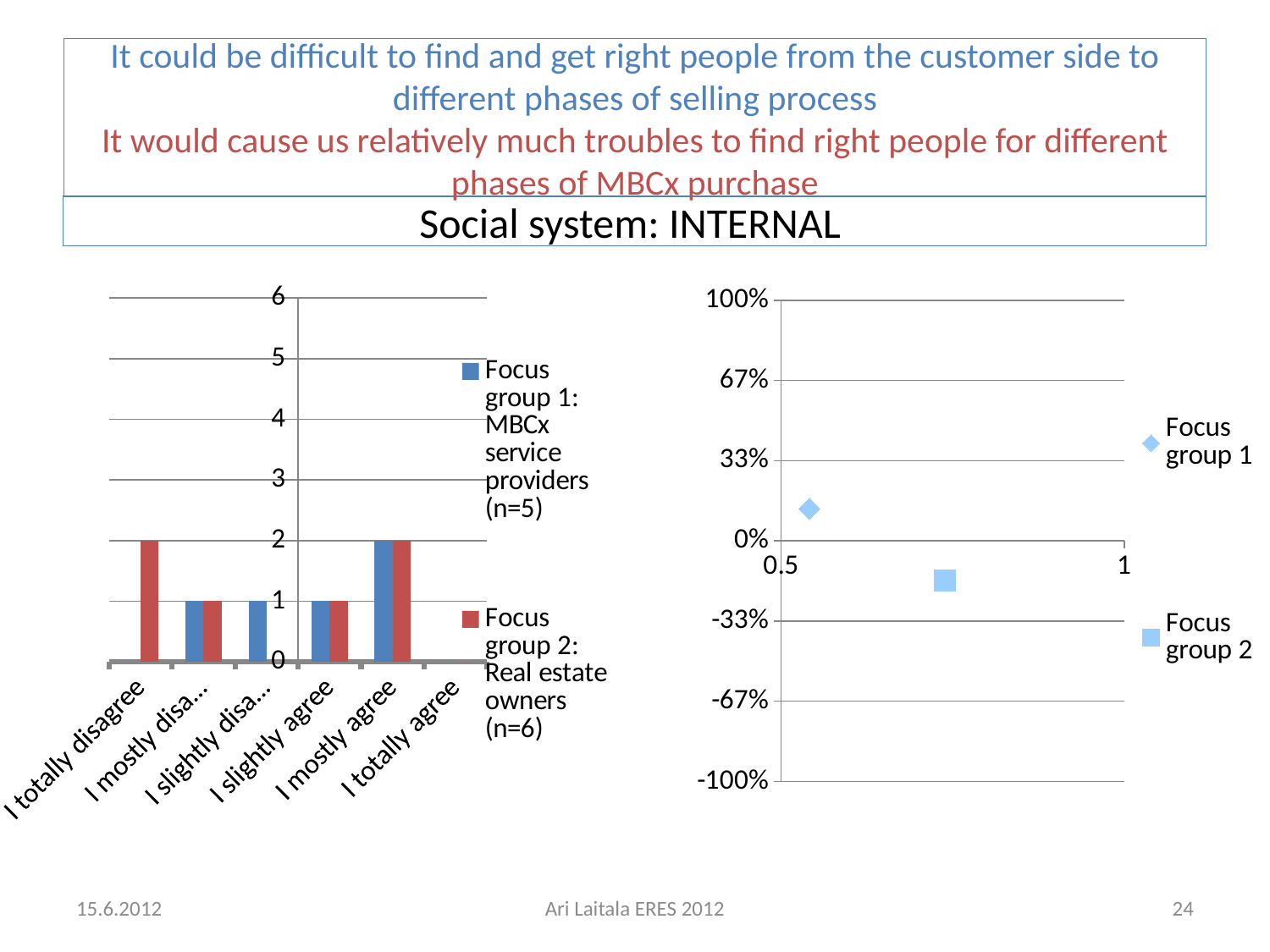
What kind of chart is the chart on the left of the slide? bar chart In the left bar chart, what is the value for Focus group 1: MBCx service providers (n=5) for 'I mostly agree'? 2 In the right scatter chart, is the value for Focus group 2 greater or less than 0%? less In the left bar chart, how many series does the legend list? 2 In the left bar chart, what is the value for Focus group 1: MBCx service providers (n=5) for 'I slightly agree'? 1 In the right scatter chart, is the value for Focus group 1 greater or less than 0%? greater In the left bar chart, which category has the highest value for Focus group 2: Real estate owners (n=6)? I totally disagree and I mostly agree (both 2) In the left bar chart, what is the value for Focus group 2: Real estate owners (n=6) for 'I totally agree'? 0 What kind of chart is the chart on the right of the slide? scatter chart In the left bar chart, how many categories are shown on the x axis? 6 In the left bar chart, what is the value for Focus group 2: Real estate owners (n=6) for 'I totally disagree'? 2 In the left bar chart, what is the difference between the Focus group 2 value and the Focus group 1 value for 'I totally disagree'? 2